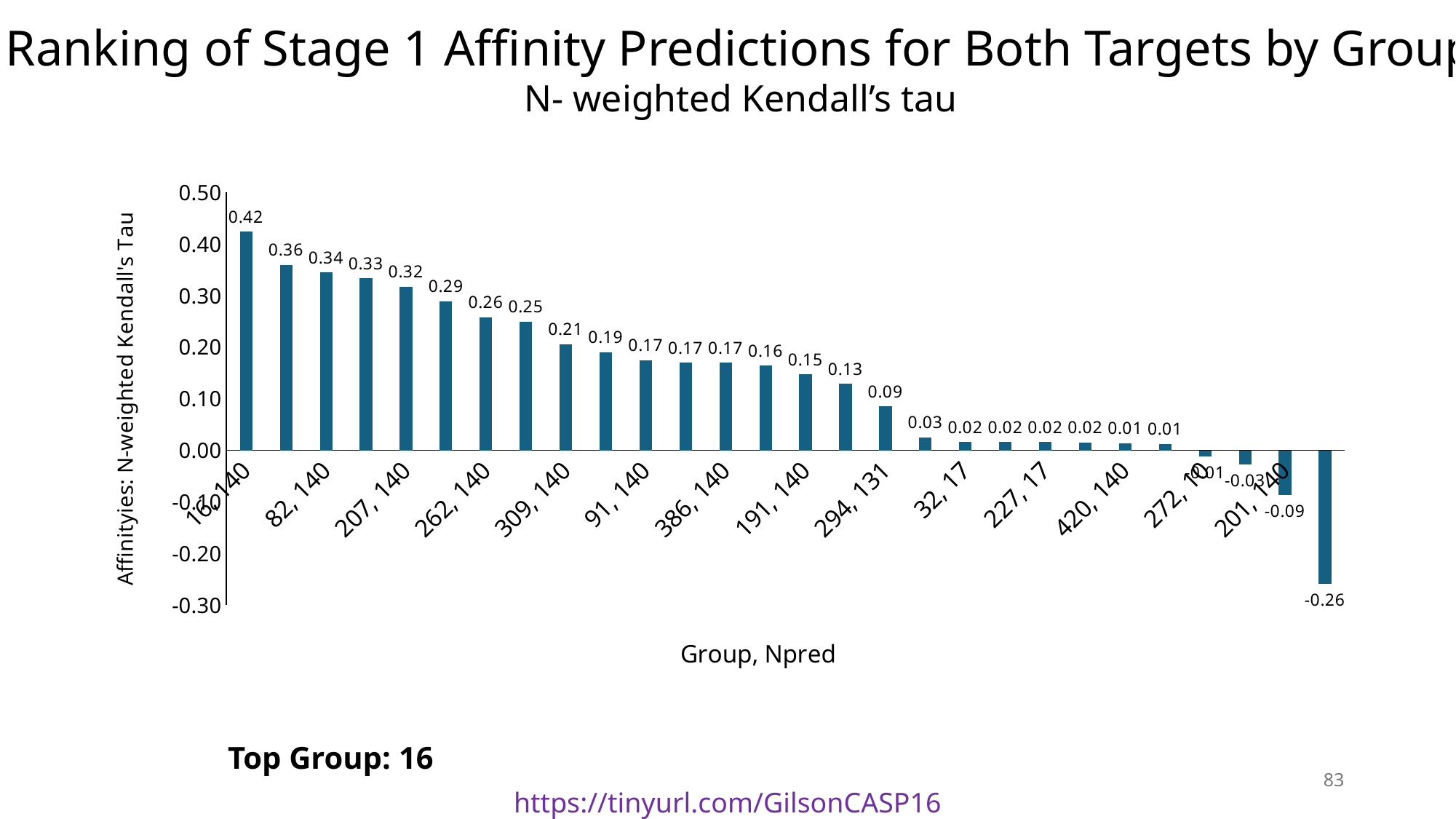
What is the highest value shown in the chart? 0.42 What is the difference between the highest value (0.42) and the second-highest value (0.36)? 0.06 How many bars are plotted in the chart? 28 What kind of chart is shown on the slide? bar chart What is the title of the y axis? Affinityies: N-weighted Kendall's Tau Is the value for group "16, 140" greater or less than 0.40? greater Which is larger, the value for group "16, 140" or the value for group "82, 140"? 16, 140 What is the N-weighted Kendall's tau value for group "16, 140"? 0.42 What is the title of the x axis? Group, Npred What is the lowest value shown in the chart? -0.26 Do the values rise or fall from left to right along the x axis? fall What is the difference between the highest value (0.42) and the lowest value (-0.26)? 0.68